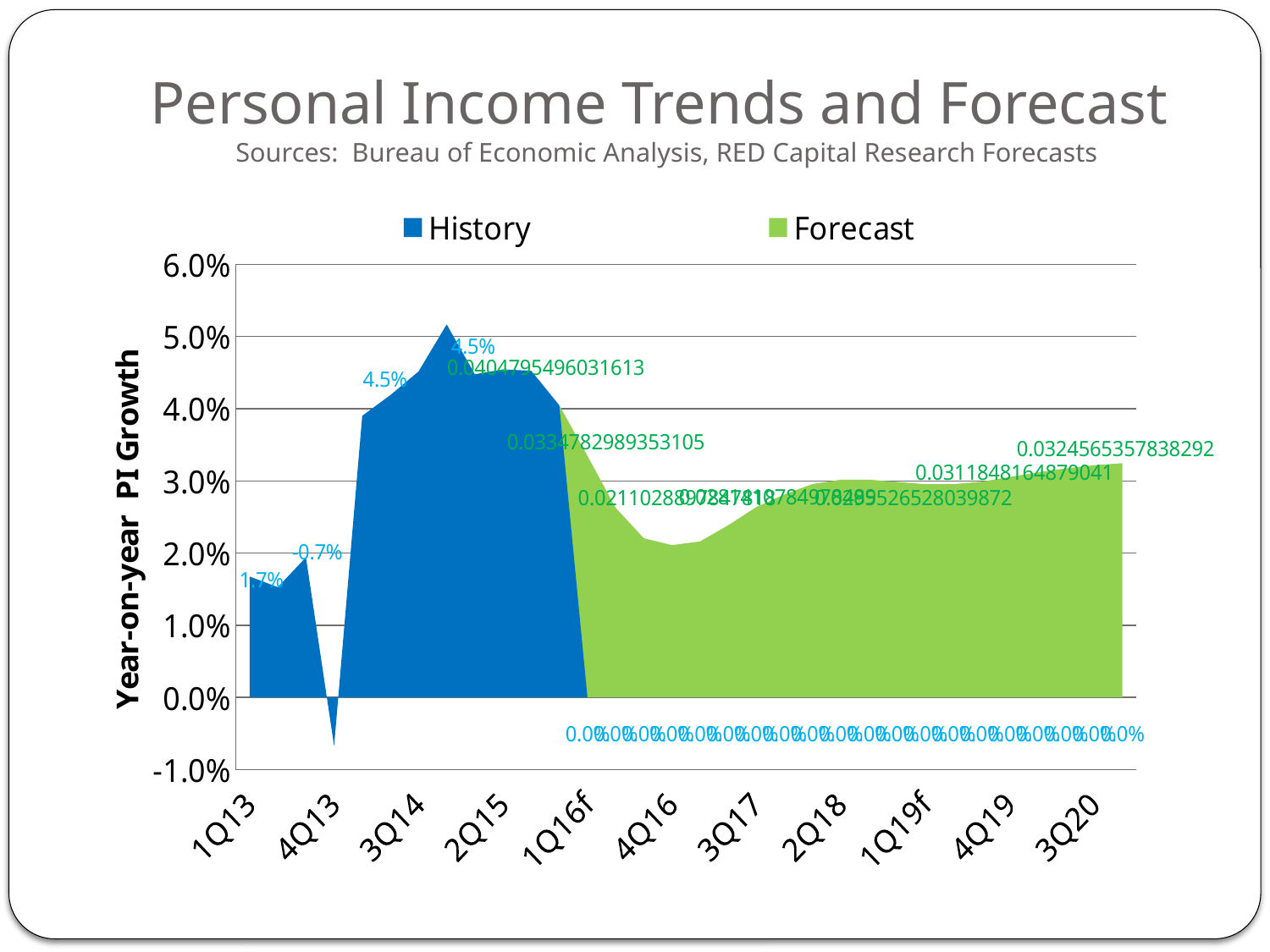
How many category labels are shown on the x axis? 11 Is the value for 4Q16 greater or less than 3.0%? less How many series does the legend list? 2 Is the lowest value of the History series greater or less than 0.0%? less What is the title of the y axis? Year-on-year PI Growth What data label is shown at 1Q13 in the History series? 1.7% Which is larger, the value at 3Q14 or the value at 4Q16? 3Q14 What are the two series named in the legend? History and Forecast What data label is shown for the last forecast point at 3Q20? 0.0324565357838292 Does the Forecast series rise or fall between 1Q16f and 4Q16? fall Is the value for 3Q14 greater or less than 3.0%? greater What kind of chart is shown on the slide? area chart